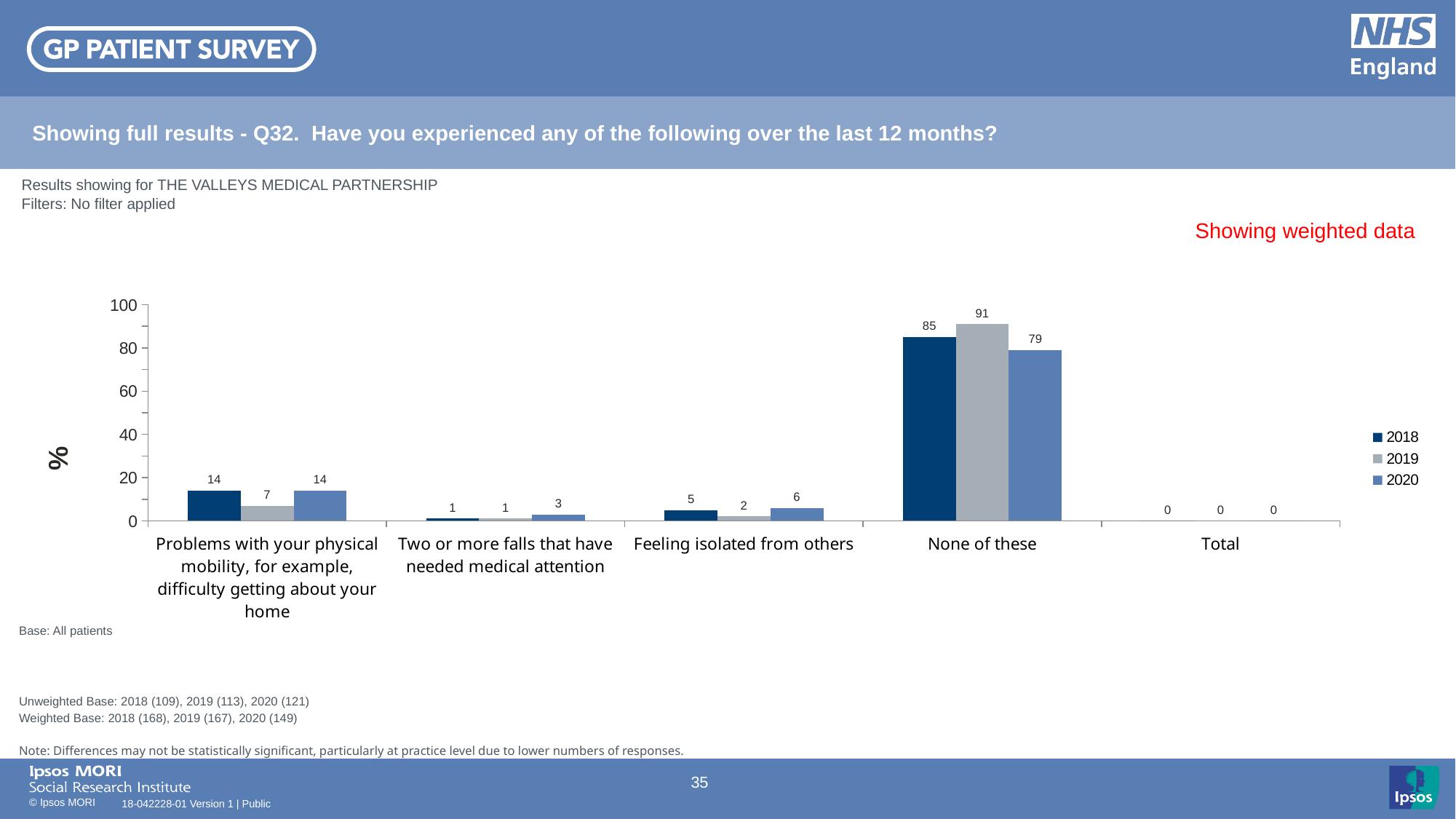
What kind of chart is shown on the slide? Bar chart How many series does the legend list? 3 What is the 2019 value for 'None of these'? 91 Which is larger for 'Feeling isolated from others': the 2018 value or the 2019 value? 2018 What is the difference between the 2019 and 2020 values for 'None of these'? 12 What is the 2020 value for 'Feeling isolated from others'? 6 How many categories are shown on the x axis? 5 What is the 2019 value for 'Problems with your physical mobility, for example, difficulty getting about your home'? 7 What is the label on the y axis? % Is the 2018 value for 'None of these' greater or less than 80? greater Which year has the lowest value for 'None of these'? 2020 Which category has the highest value for the 2020 series? None of these